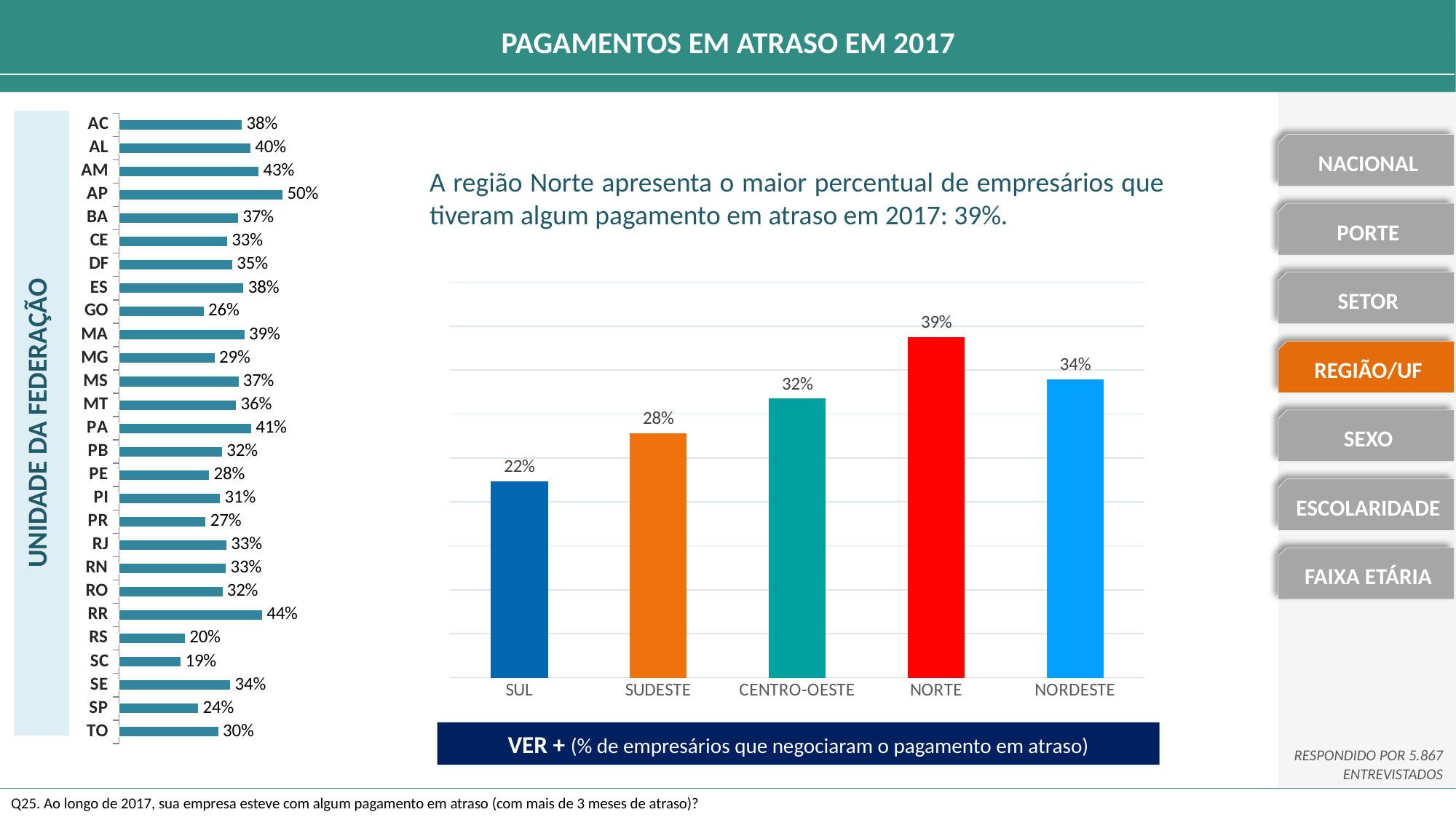
In the state bar chart on the left (Unidade da Federação), how many states are listed? 27 In the state bar chart on the left (Unidade da Federação), what is the difference between RR and RS? 24% In the region bar chart on the right, what is the difference between NORDESTE and SUDESTE? 6% In the state bar chart on the left (Unidade da Federação), which state has the highest value? AP What type of chart is the region chart on the right? Bar chart In the region bar chart on the right, how many regions are shown? 5 In the state bar chart on the left (Unidade da Federação), what is the value for SP? 24% In the region bar chart on the right, which is larger, CENTRO-OESTE or SUDESTE? CENTRO-OESTE In the region bar chart on the right, which region has the lowest value? SUL In the region bar chart on the right, what is the value for NORTE? 39% In the state bar chart on the left (Unidade da Federação), which state has the lowest value? SC In the state bar chart on the left (Unidade da Federação), what is the value for AP? 50%